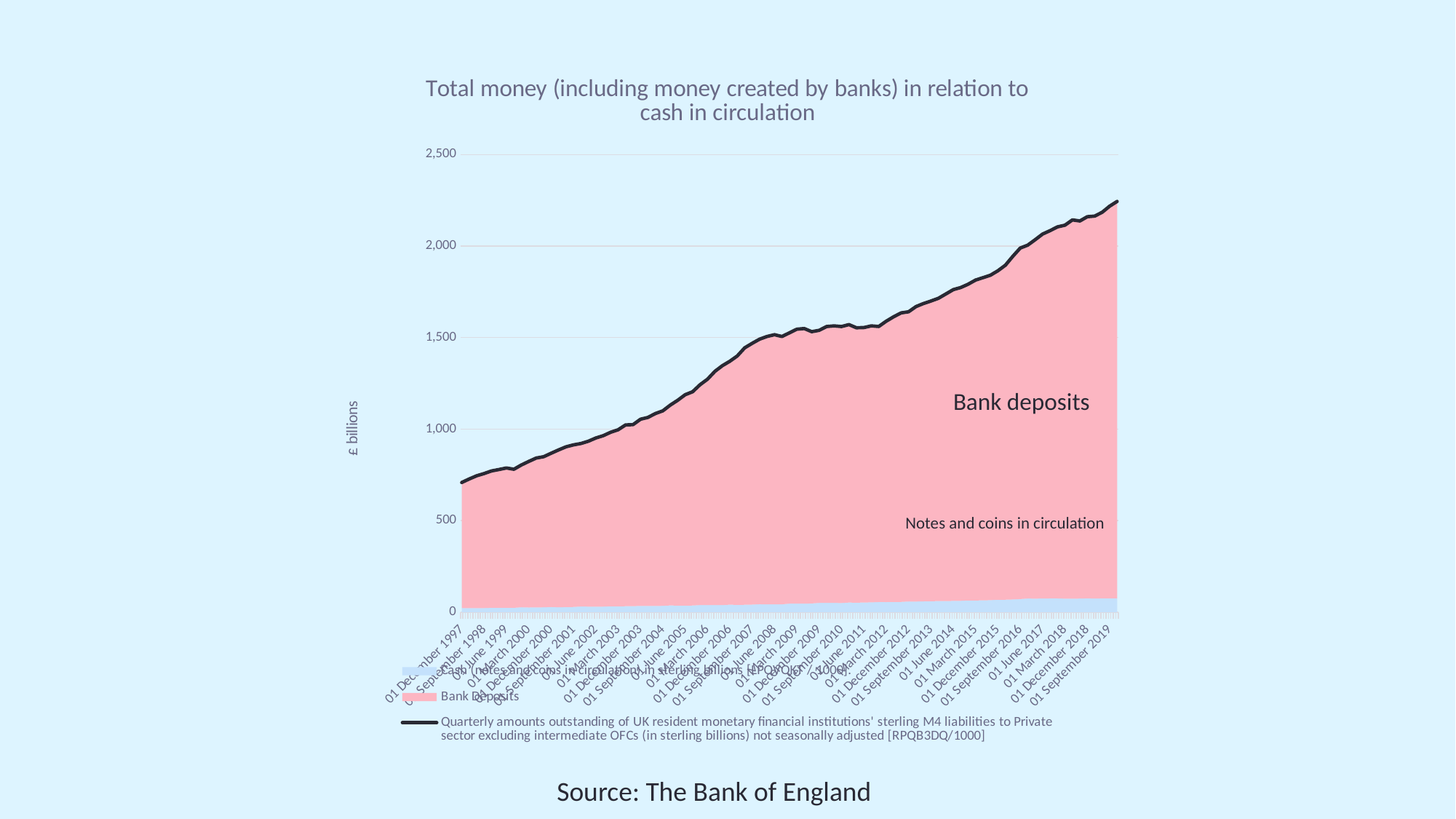
Is the value of the total money line at 01 September 2019 greater or less than 2,000? greater Does the total money line rise or fall from 01 December 1997 to 01 September 2019? Rises What kind of chart is shown on the slide? Area chart with a line Is the value of the total money line at 01 March 2006 greater or less than 1,000? greater Is the value of the total money line at 01 December 1997 greater or less than 1,000? less How many series does the legend list? 3 What is the label on the vertical axis of the chart? £ billions Which is larger, the total money value at 01 September 2019 or at 01 December 1997? 01 September 2019 What is the title of the chart? Total money (including money created by banks) in relation to cash in circulation